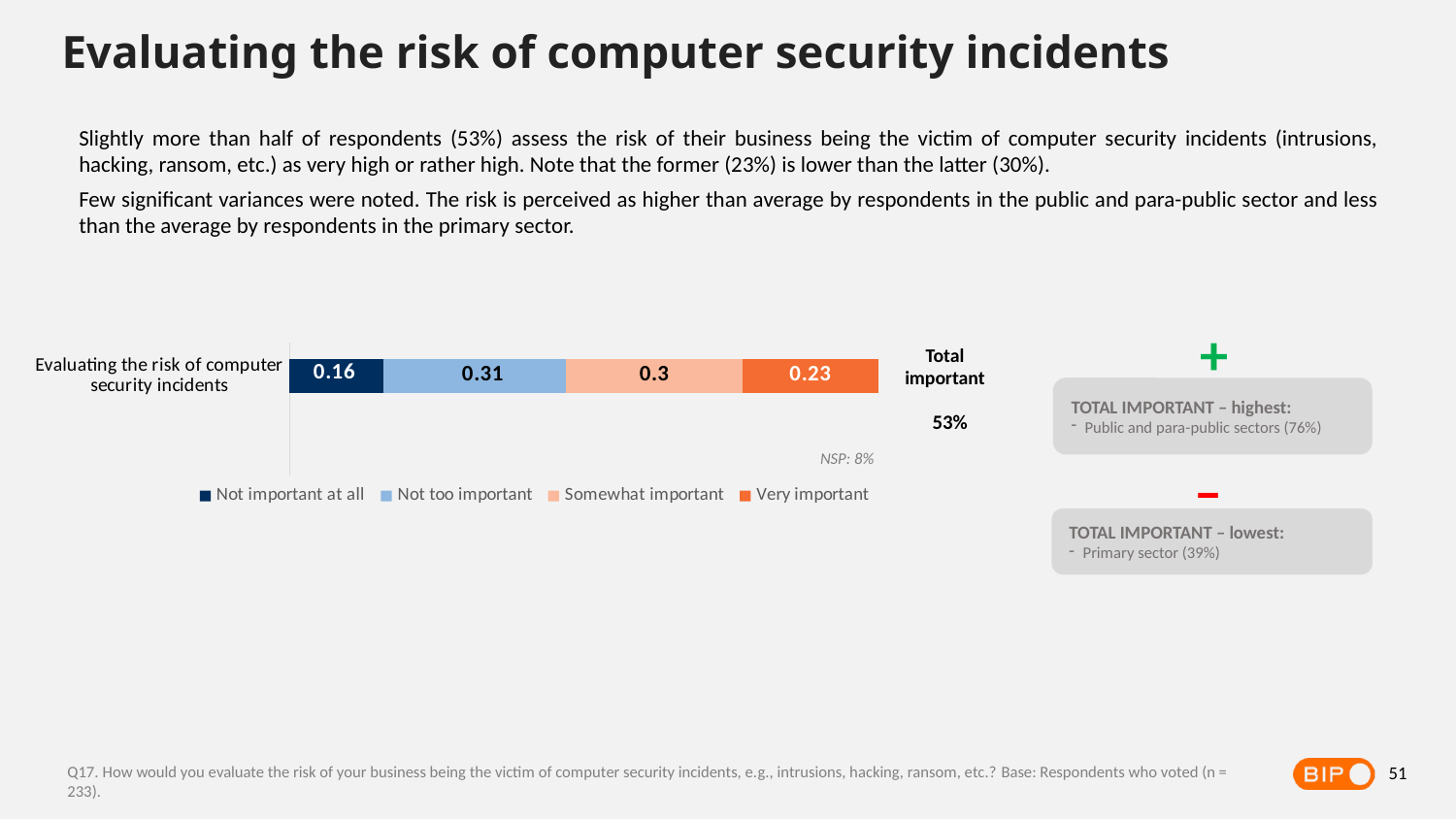
What is the value for the 'Not important at all' segment? 0.16 Which segment of the bar has the lowest value? Not important at all How many categories (bars) are plotted in the chart? 1 Which segment of the bar has the highest value? Not too important How many series does the legend list? 4 What is the value for the 'Not too important' segment? 0.31 What kind of chart is shown on the slide? Stacked bar chart What is the value for the 'Somewhat important' segment? 0.3 What is the value for the 'Very important' segment? 0.23 Which is larger, the 'Not too important' value or the 'Very important' value? Not too important What is the difference between the 'Very important' and 'Not important at all' values? 0.07 What is the total of the four segments in the stacked bar? 1